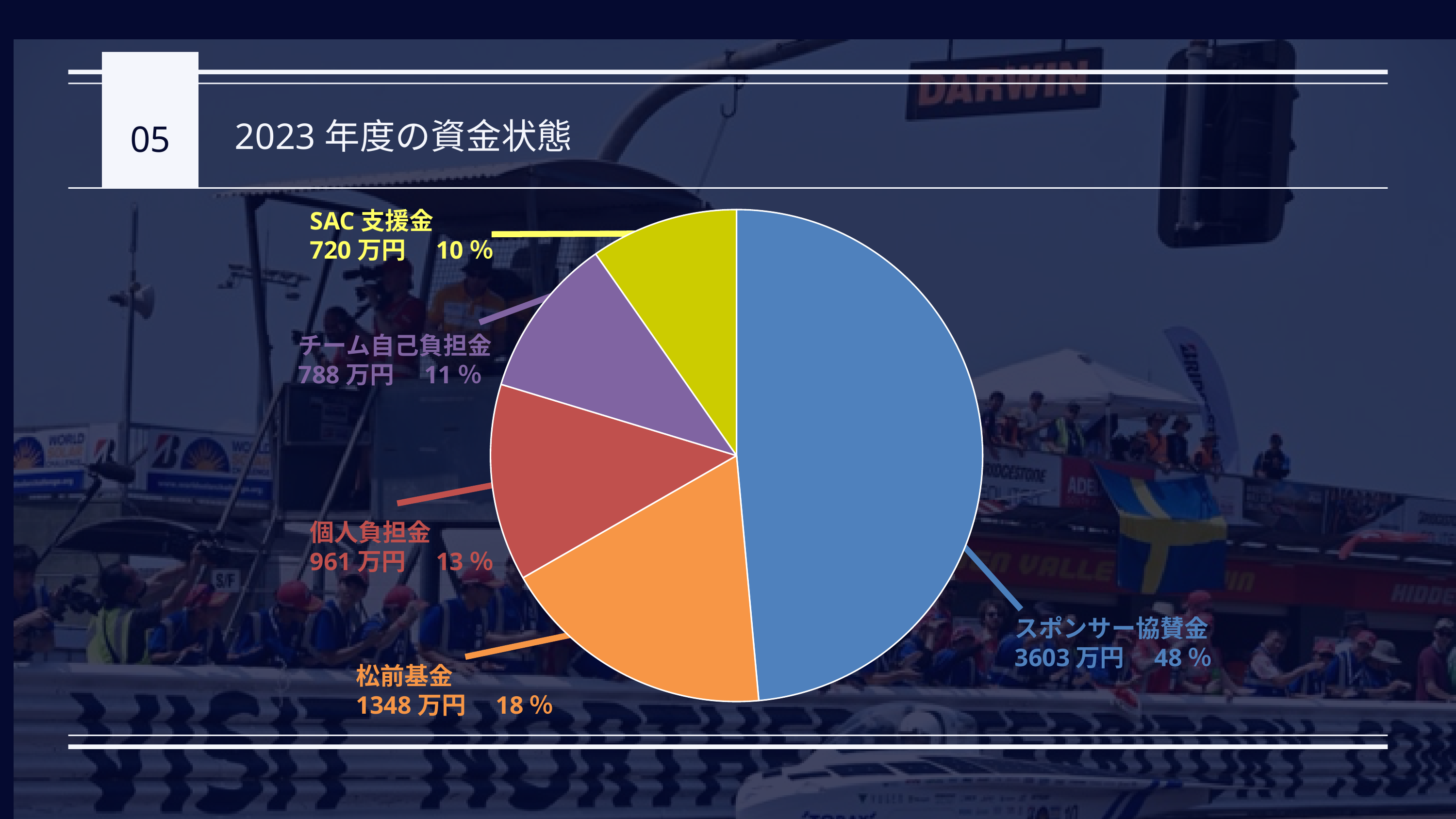
What is the difference between the values for スポンサー協賛金 and 松前基金? 2255 万円 What is the value for SAC 支援金? 720 万円 Which category has the largest slice of the pie? スポンサー協賛金 Which category has the smallest slice of the pie? SAC 支援金 Which is larger, the value for 個人負担金 or the value for チーム自己負担金? 個人負担金 What is the value for スポンサー協賛金? 3603 万円 What is the value for 松前基金? 1348 万円 What kind of chart is shown on the slide? pie chart What is the title of the slide's chart? 2023 年度の資金状態 What share of the pie is 個人負担金? 13 % What share of the pie is チーム自己負担金? 11 % How many slices does the pie chart have? 5